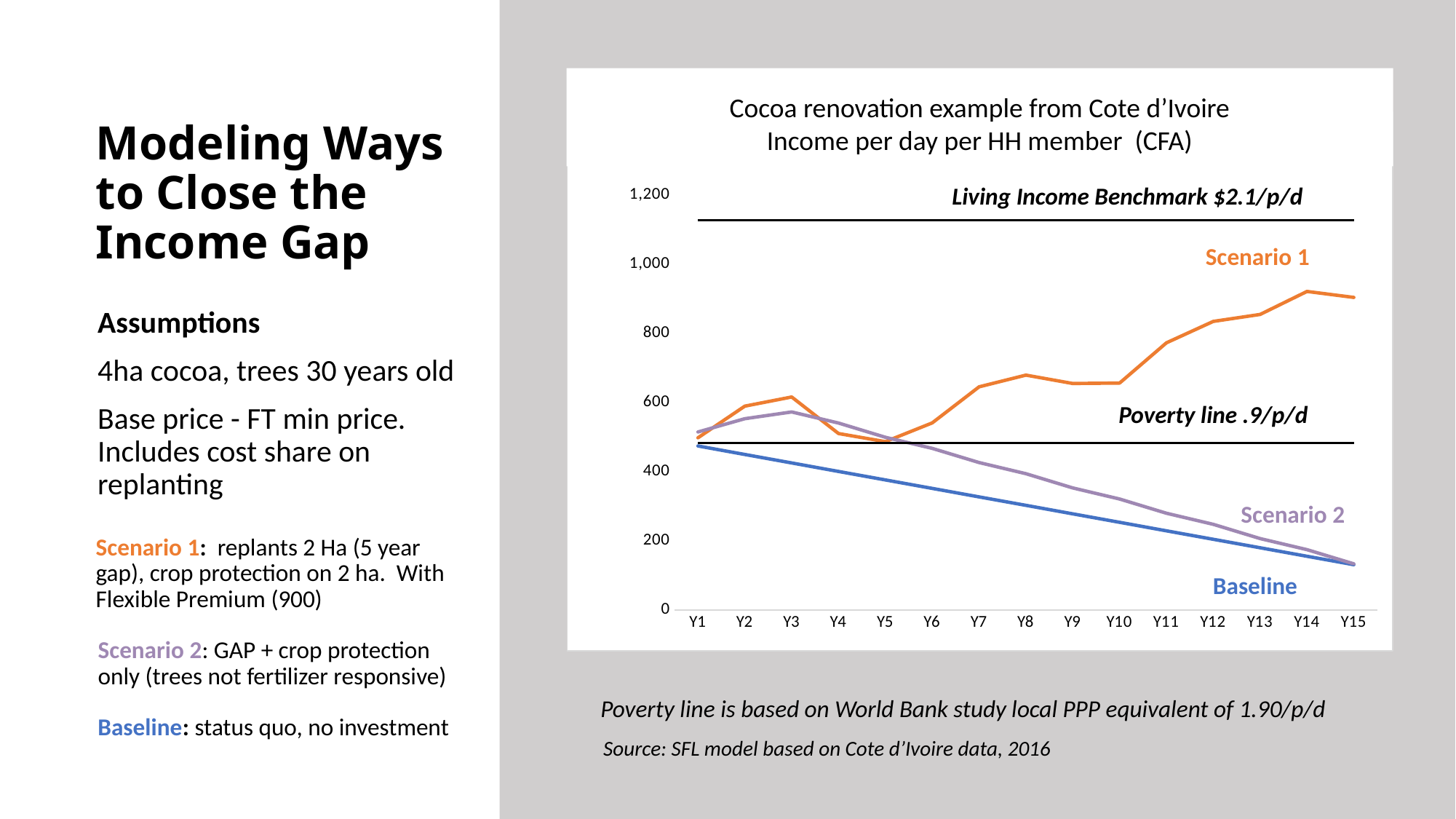
Is the value for Baseline at Y15 greater or less than 200? less What is the label of the upper horizontal reference line on the chart? Living Income Benchmark $2.1/p/d Is the value for Scenario 2 at Y10 greater or less than 400? less How many years (points) are shown along the x axis of the chart? 15 How many data series are labeled on the chart (excluding the benchmark and poverty reference lines)? 3 Does the Scenario 1 line rise or fall overall from Y5 to Y15? rise Which series has the highest value at Y15? Scenario 1 Does the Baseline line rise or fall from Y1 to Y15? fall At Y15, which is larger: Scenario 1 or Baseline? Scenario 1 What kind of chart is shown on the slide? line chart What is the label of the lower horizontal reference line on the chart? Poverty line .9/p/d Is the value for Scenario 1 at Y15 greater or less than 800? greater